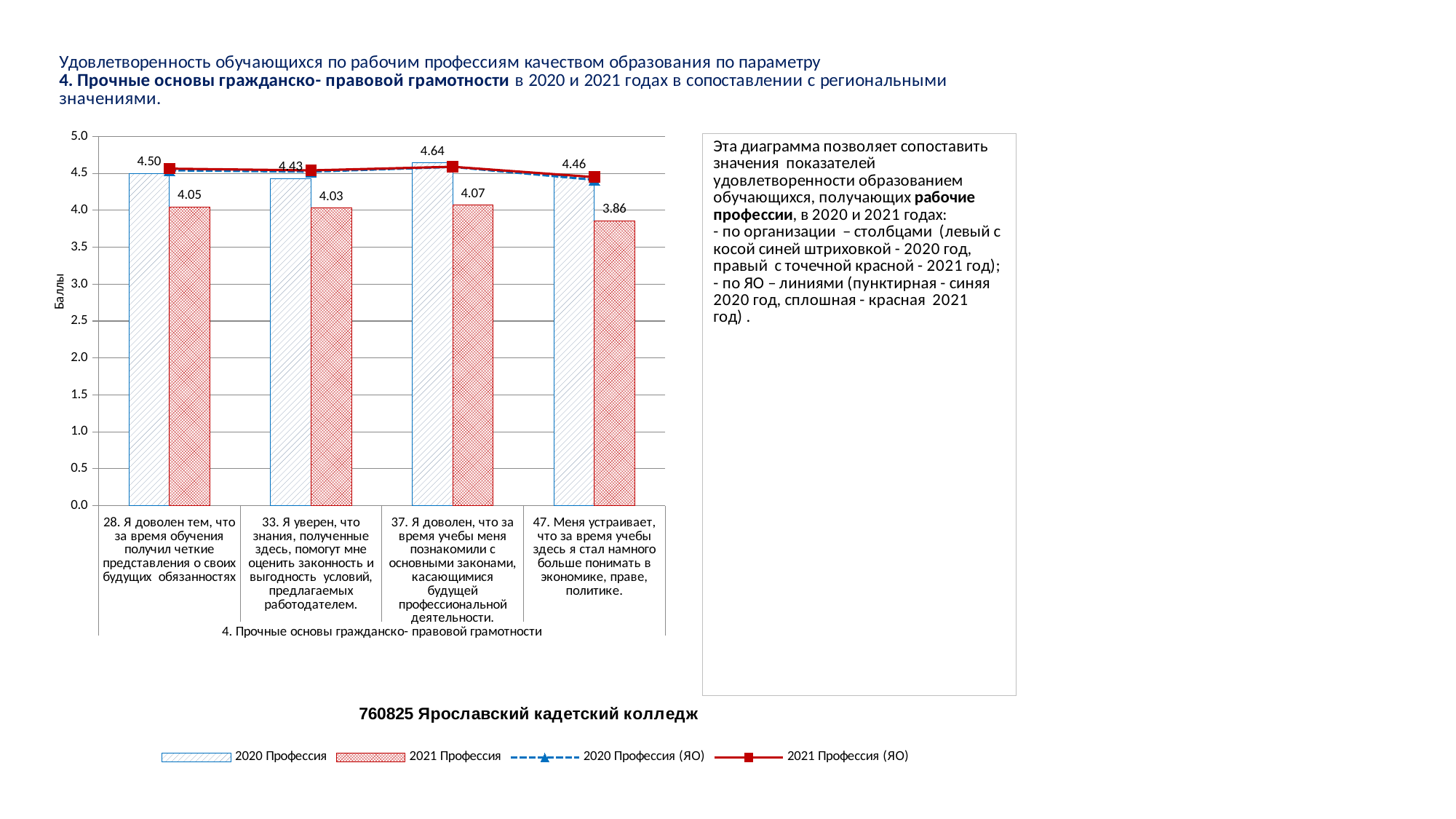
For item 33, which is larger: the 2020 Профессия bar or the 2021 Профессия bar? 2020 Профессия What kind of chart is shown on the slide? Combined bar and line chart What is the value of the 2020 Профессия bar for item 28 (Я доволен тем, что за время обучения получил четкие представления о своих будущих обязанностях)? 4.50 Is the 2021 Профессия value for item 28 greater or less than 4.5? less Which item has the highest 2020 Профессия bar? 37. Я доволен, что за время учебы меня познакомили с основными законами, касающимися будущей профессиональной деятельности. Which item has the lowest 2021 Профессия bar? 47. Меня устраивает, что за время учебы здесь я стал намного больше понимать в экономике, праве, политике. How many series does the chart legend list? 4 How many survey items (categories) are shown on the x axis of the chart? 4 What is the difference between the 2020 Профессия and 2021 Профессия values for item 47? 0.60 What is the label of the vertical axis of the chart? Баллы What is the value of the 2021 Профессия bar for item 47 (Меня устраивает, что за время учебы здесь я стал намного больше понимать в экономике, праве, политике)? 3.86 What is the value of the 2021 Профессия bar for item 37 (Я доволен, что за время учебы меня познакомили с основными законами)? 4.07